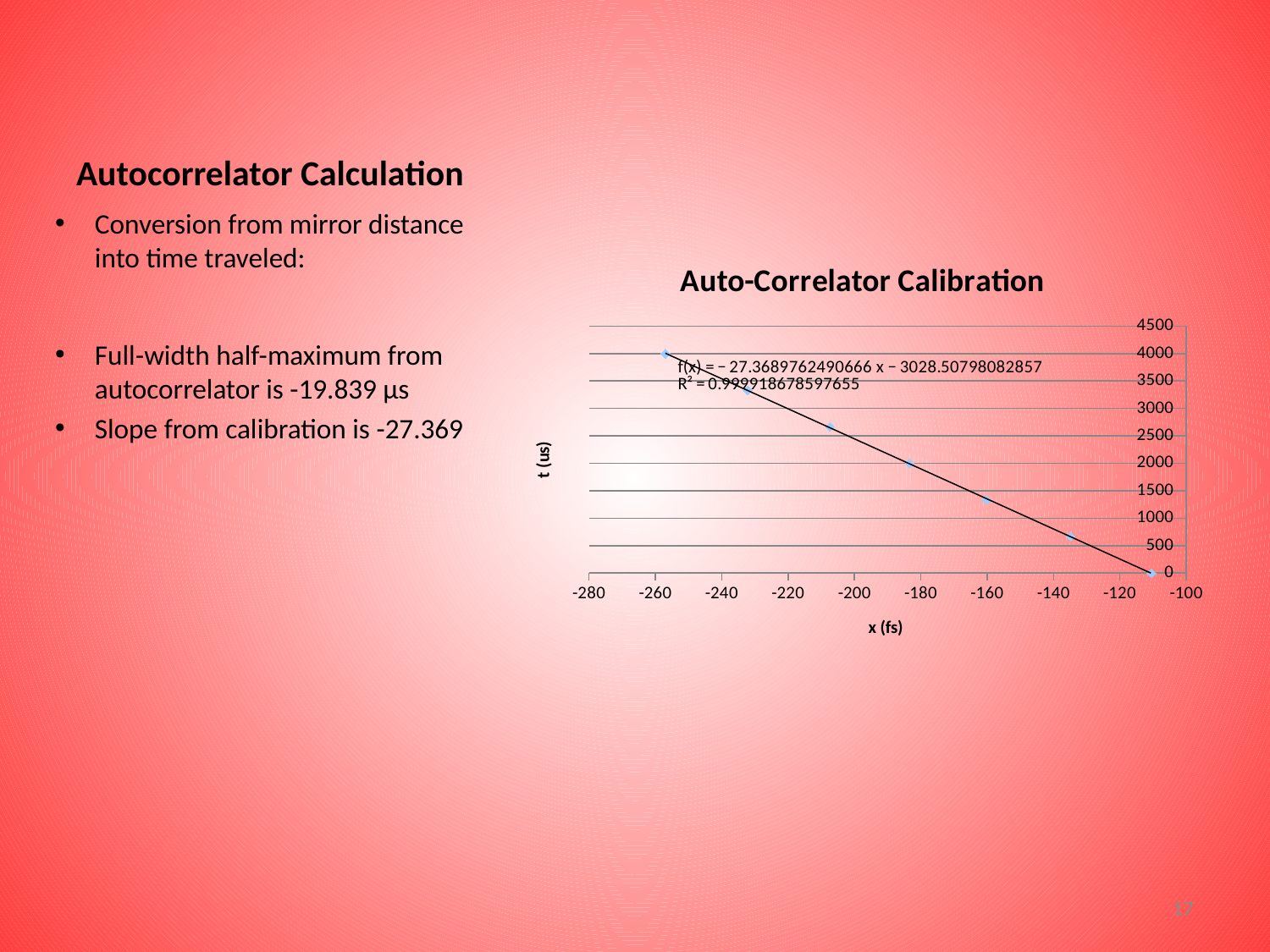
How many data points are plotted on the chart? 7 What is the title of the chart? Auto-Correlator Calibration Is the value of t at the data point near x = -135 greater or less than 1000? less Which data point has the highest t value: the one near x = -257 or the one near x = -110? the one near x = -257 Do the plotted t values rise or fall as x increases from -280 to -100? fall What is the highest tick value shown on the y axis of the chart? 4500 What kind of chart is shown on the slide? scatter chart with a linear trendline Is the value of t at the data point near x = -257 greater or less than 3500? greater Is the value of t at the data point near x = -180 greater or less than 1500? greater What is the label of the x axis of the chart? x (fs)